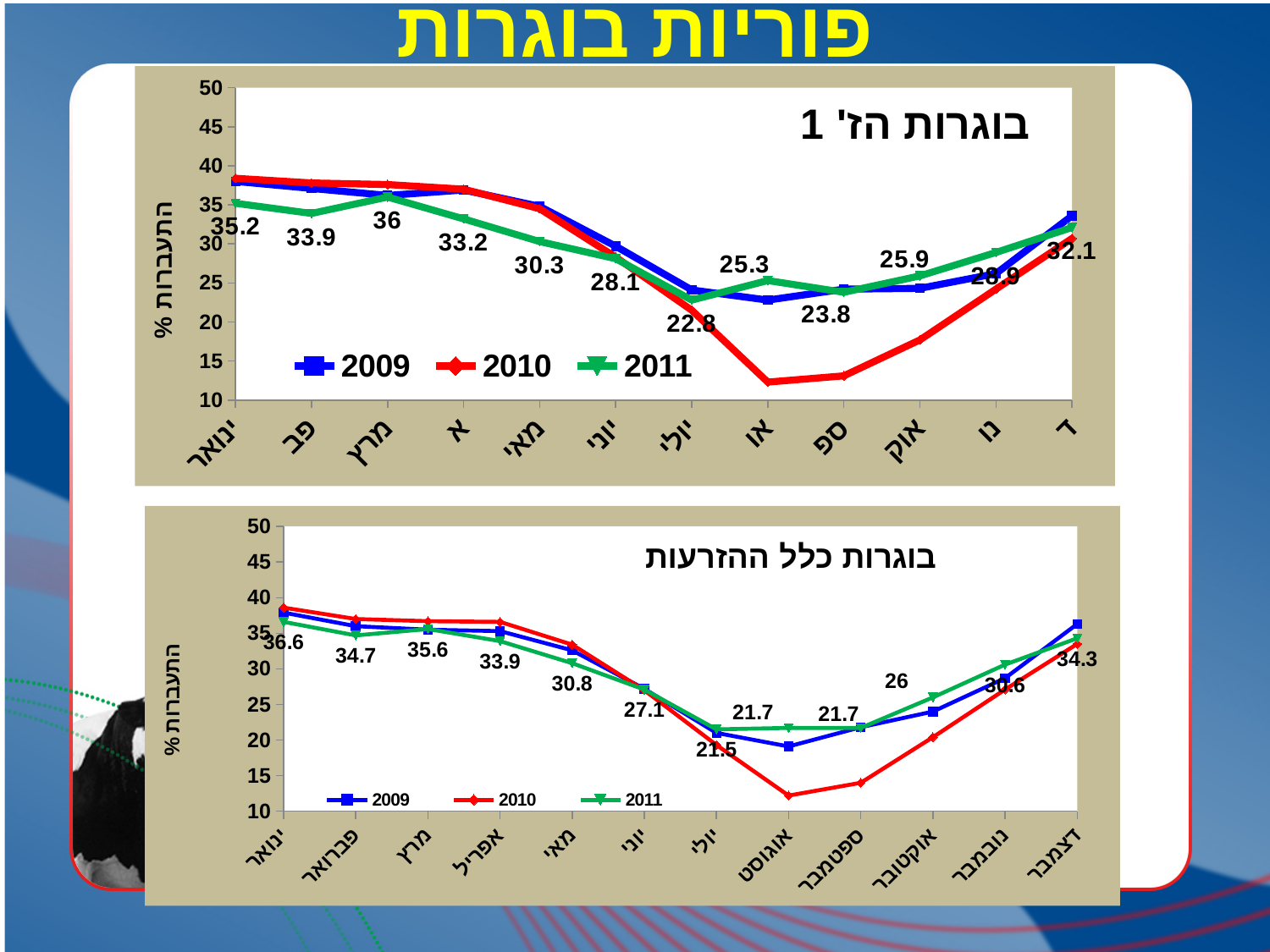
In the top chart (בוגרות הז' 1), how many series does the legend list? 3 In the top chart (בוגרות הז' 1), what is the labelled value for 2011 in March (מרץ)? 36 What kind of chart is the bottom chart (בוגרות כלל ההזרעות)? line chart In the bottom chart (בוגרות כלל ההזרעות), how many months are shown on the x axis? 12 In the top chart (בוגרות הז' 1), is the 2010 value for August (או) greater or less than 15? less In the top chart (בוגרות הז' 1), what is the difference between the labelled 2011 values for January (ינואר) and December (ד)? 3.1 In the bottom chart (בוגרות כלל ההזרעות), is the 2011 value for January (ינואר) larger or smaller than the 2011 value for July (יולי)? larger In the top chart (בוגרות הז' 1), what is the labelled value for 2011 in July (יולי)? 22.8 In the bottom chart (בוגרות כלל ההזרעות), what is the labelled value for 2011 in October (אוקטובר)? 26 In the bottom chart (בוגרות כלל ההזרעות), which month has the highest labelled 2011 value? ינואר In the top chart (בוגרות הז' 1), which month has the lowest labelled 2011 value? יולי In the bottom chart (בוגרות כלל ההזרעות), do the labelled 2011 values rise or fall from January (ינואר) to July (יולי)? fall